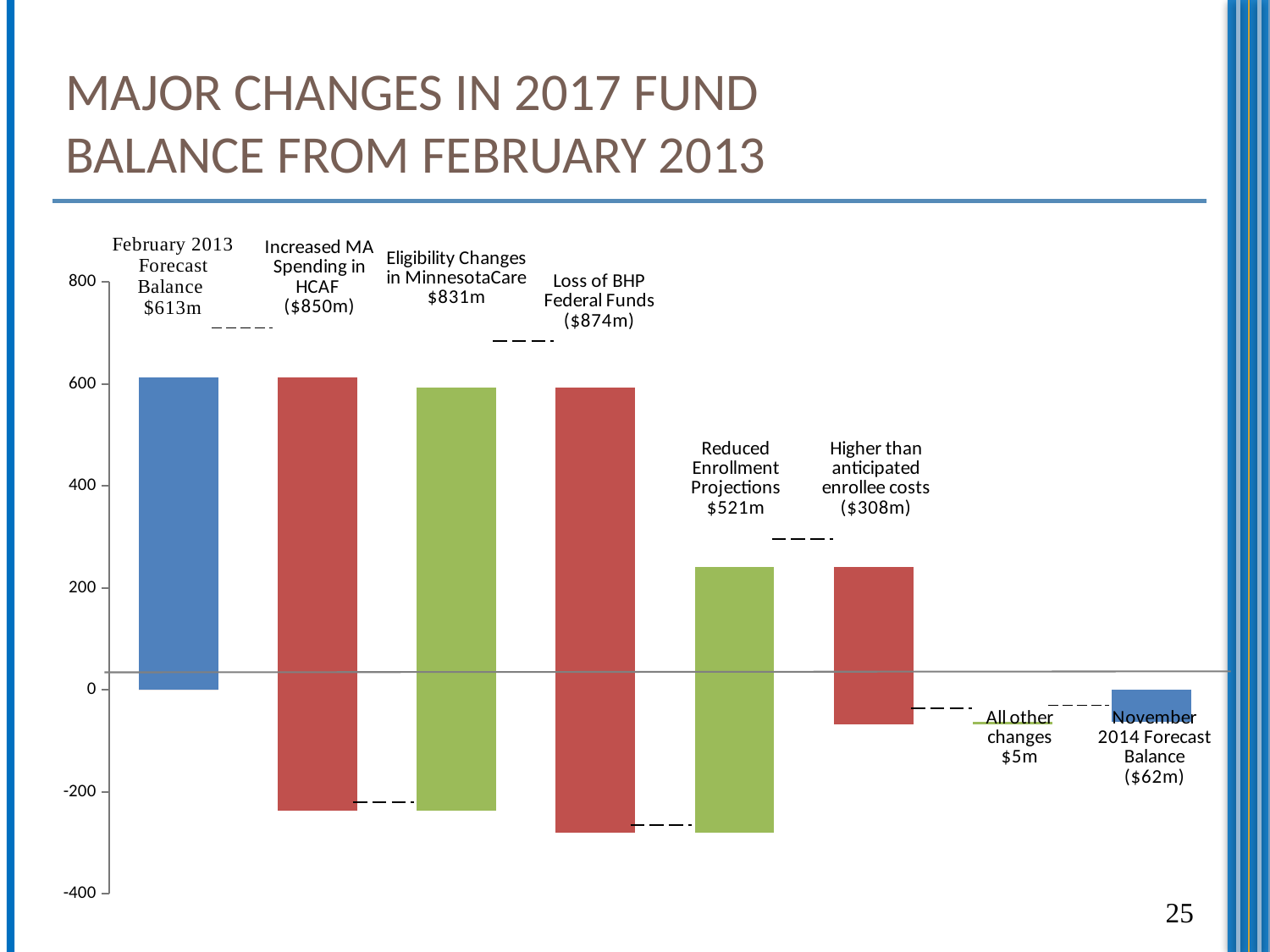
Which change has the smallest labelled amount? All other changes What is the February 2013 Forecast Balance shown on the chart? $613m What value is labelled for Loss of BHP Federal Funds? ($874m) By how much does the Loss of BHP Federal Funds amount exceed the Increased MA Spending in HCAF amount? $24m What is the November 2014 Forecast Balance shown on the chart? ($62m) Which is larger in amount: Eligibility Changes in MinnesotaCare or Reduced Enrollment Projections? Eligibility Changes in MinnesotaCare What value is labelled for Reduced Enrollment Projections? $521m What is the title of the slide? MAJOR CHANGES IN 2017 FUND BALANCE FROM FEBRUARY 2013 What kind of chart is shown on the slide? Bar chart How many bars are plotted on the chart? 8 Which change has the largest labelled amount? Loss of BHP Federal Funds What value is labelled for Higher than anticipated enrollee costs? ($308m)